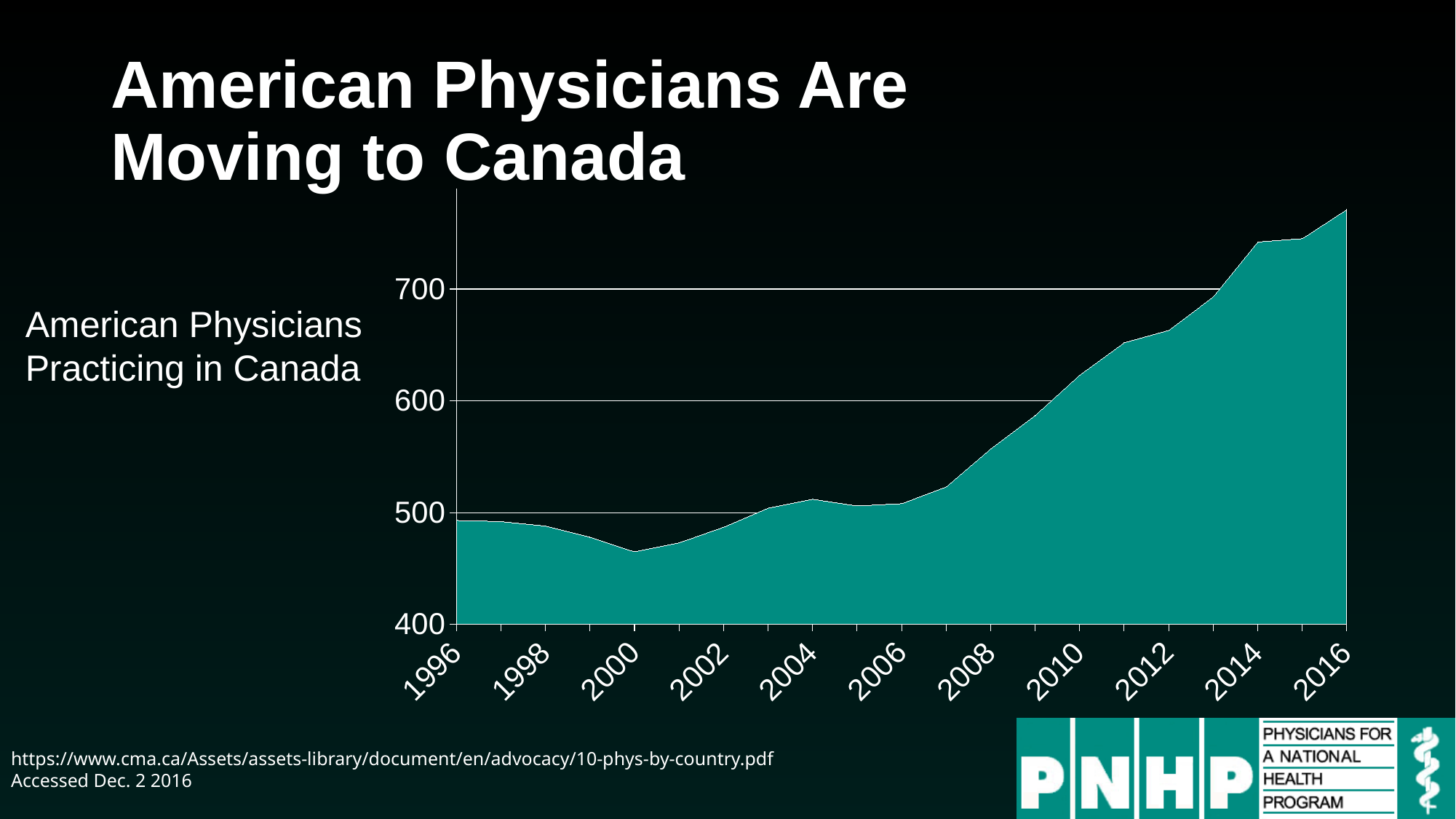
Overall, do the values rise or fall from 1996 to 2016? rise Which year has a larger value, 1996 or 2016? 2016 What is the title of the chart on the slide? American Physicians Practicing in Canada In which year is the number of American physicians practicing in Canada highest? 2016 What colour is the filled area in the chart? teal Is the value for 2000 greater or less than 500? less Is the value for 2012 greater or less than 600? greater In which year is the number of American physicians practicing in Canada lowest? 2000 Is the value for 2008 greater or less than 600? less What kind of chart is shown on the slide? area chart